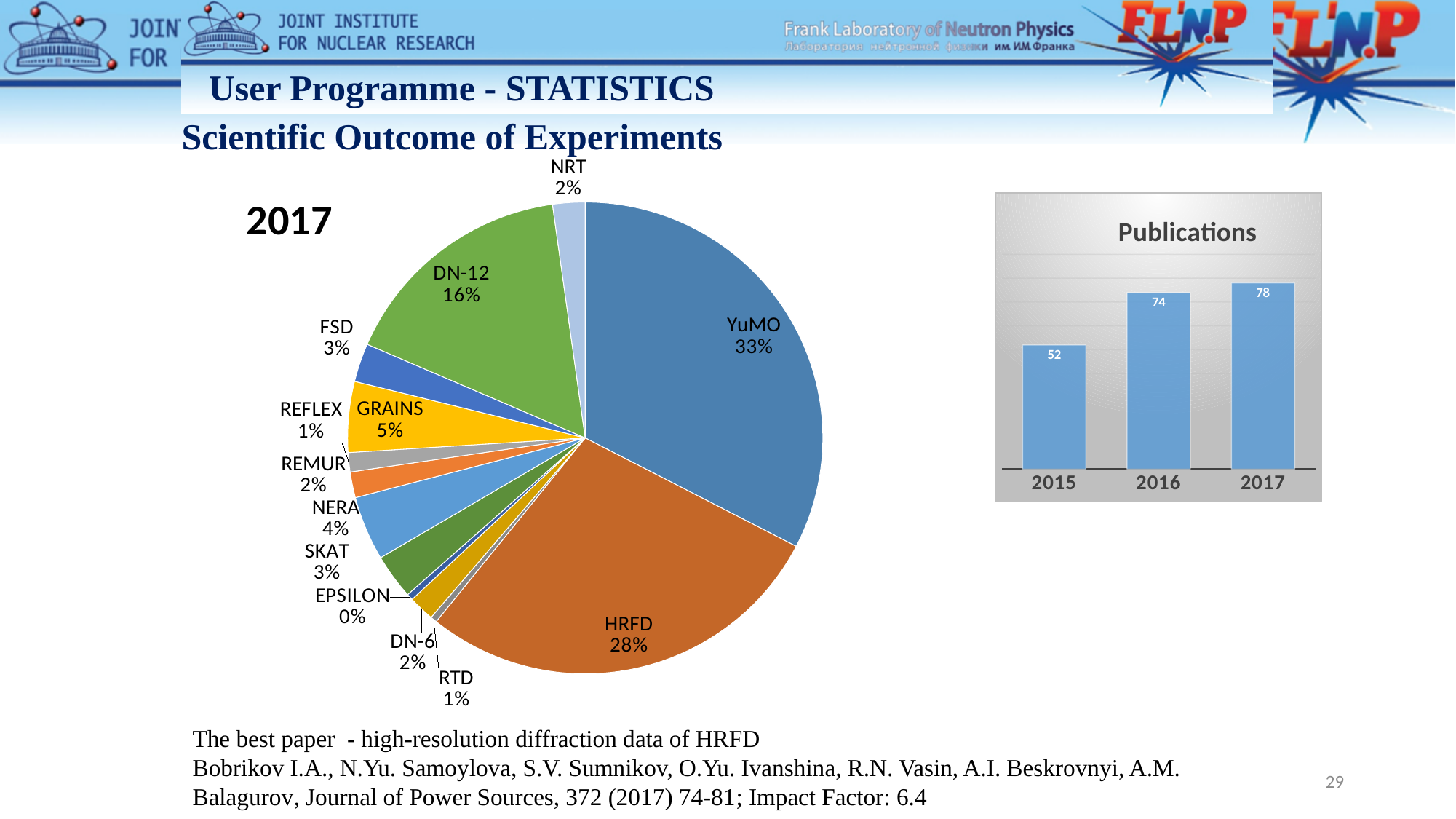
In the 2017 pie chart, which instrument has the largest share? YuMO In the 2017 pie chart, which is larger, the share for GRAINS or the share for NERA? GRAINS In the Publications chart, do the values rise or fall from 2015 to 2017? rise In the 2017 pie chart, what share does DN-12 have? 16% In the Publications chart, how many publications were there in 2015? 52 What kind of chart is the 2017 chart on the left? pie chart In the 2017 pie chart, what is the difference in percentage points between YuMO and HRFD? 5 In the 2017 pie chart, what share does YuMO have? 33% In the Publications chart, which year has the lowest value? 2015 In the Publications chart, what is the difference between 2017 and 2015? 26 In the 2017 pie chart, what share does HRFD have? 28% In the Publications chart, how many publications were there in 2017? 78